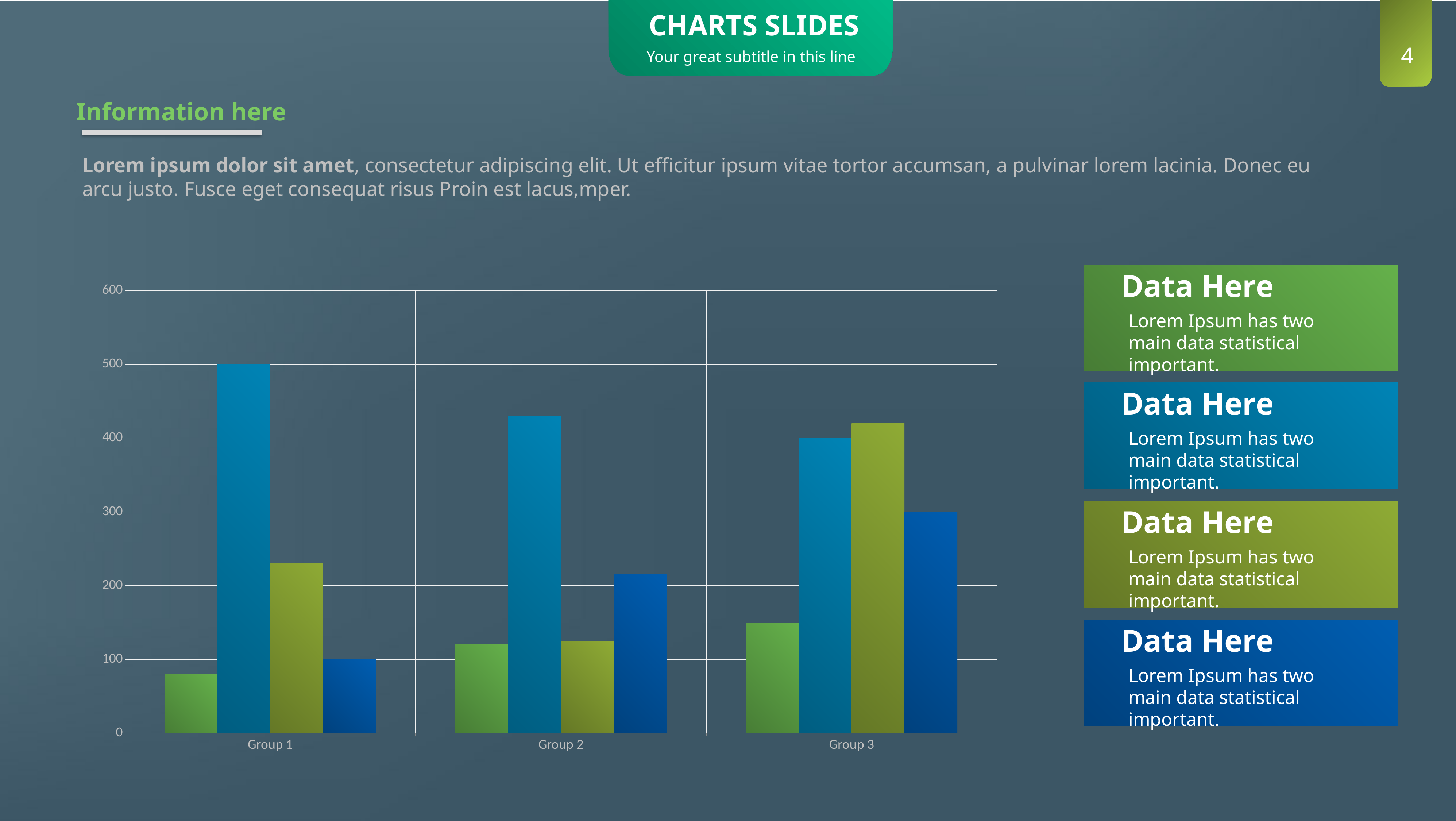
What is the difference between the light blue bar and the dark blue bar for Group 1? 400 Which bar is the lowest in Group 1? the green bar Is the value of the light blue bar for Group 2 greater or less than 400? greater Which group has the tallest bar in the chart? Group 1 Is the value of the green bar for Group 1 greater or less than 100? less What is the value of the dark blue bar for Group 3? 300 What is the value of the dark blue bar for Group 1? 100 How many groups are shown on the x axis of the chart? 3 What is the value of the light blue bar for Group 1? 500 What is the value of the light blue bar for Group 3? 400 What kind of chart is shown on the slide? bar chart Do the light blue bars rise or fall from Group 1 to Group 3? fall